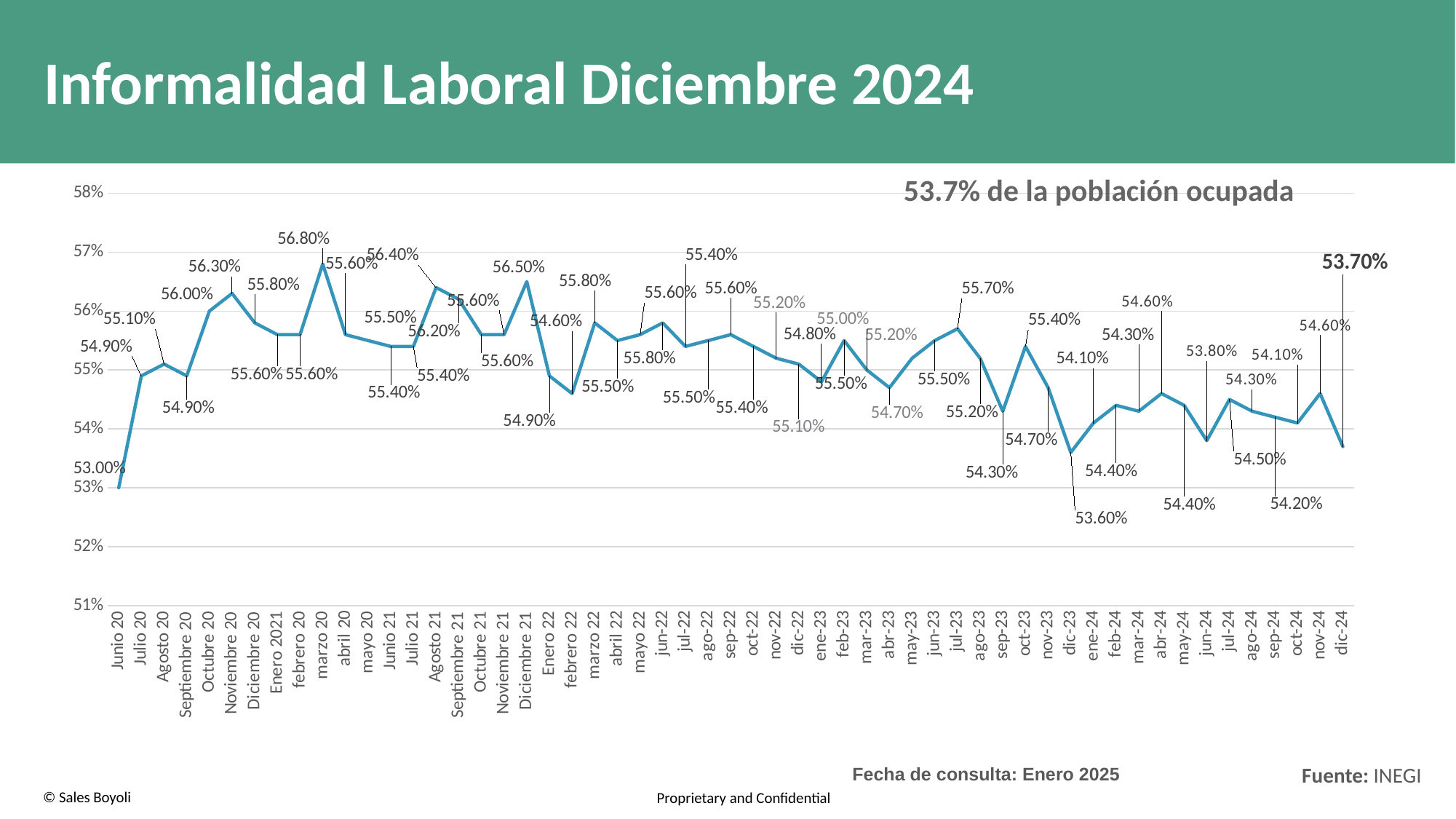
Do the values rise or fall from jul-23 to dic-23? fall What is the value for dic-24? 53.70% What is the difference between the values for nov-24 and dic-24? 0.90% What is the value for marzo 20? 56.80% Which month has the highest value on the chart? marzo 20 Is the value for Junio 20 greater or less than 54%? less What type of chart is shown on the slide? line chart How many data points are plotted on the chart? 55 What is the value for jul-23? 55.70% Which month has the lowest value on the chart? Junio 20 What is the value for dic-23? 53.60% Which is larger, the value for dic-23 or the value for dic-24? dic-24